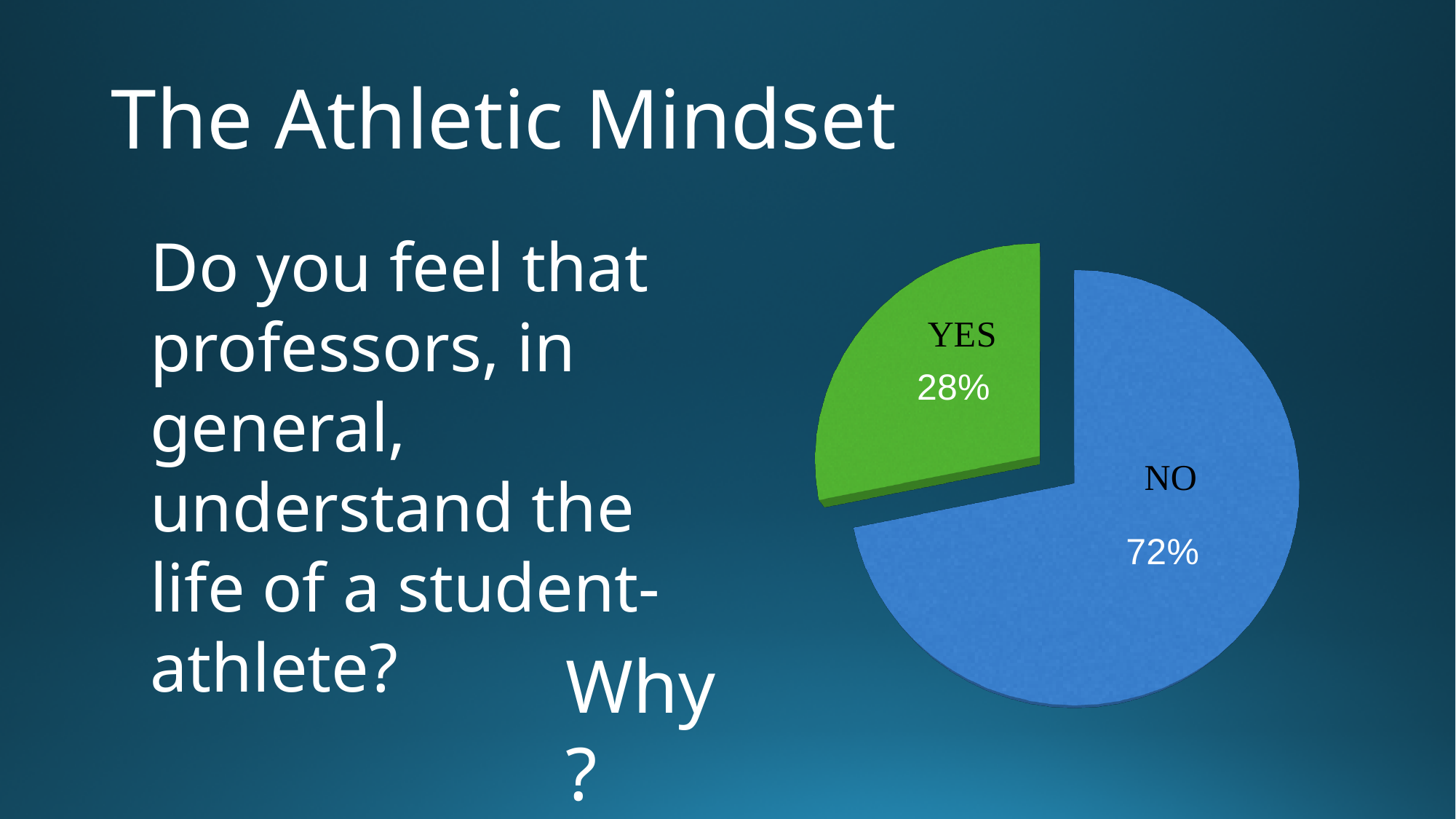
Which slice is larger, YES or NO? NO What colour is the NO slice? Blue What share of the pie does the YES slice represent? 28% What percentage of respondents answered YES? 28% What colour is the YES slice? Green How many slices does the pie chart have? 2 What is the difference in percentage points between the NO and YES slices? 44 What percentage of respondents answered NO? 72% Which response has the smallest share of the pie? YES What kind of chart is shown on the slide? Pie chart Which response has the largest share of the pie? NO